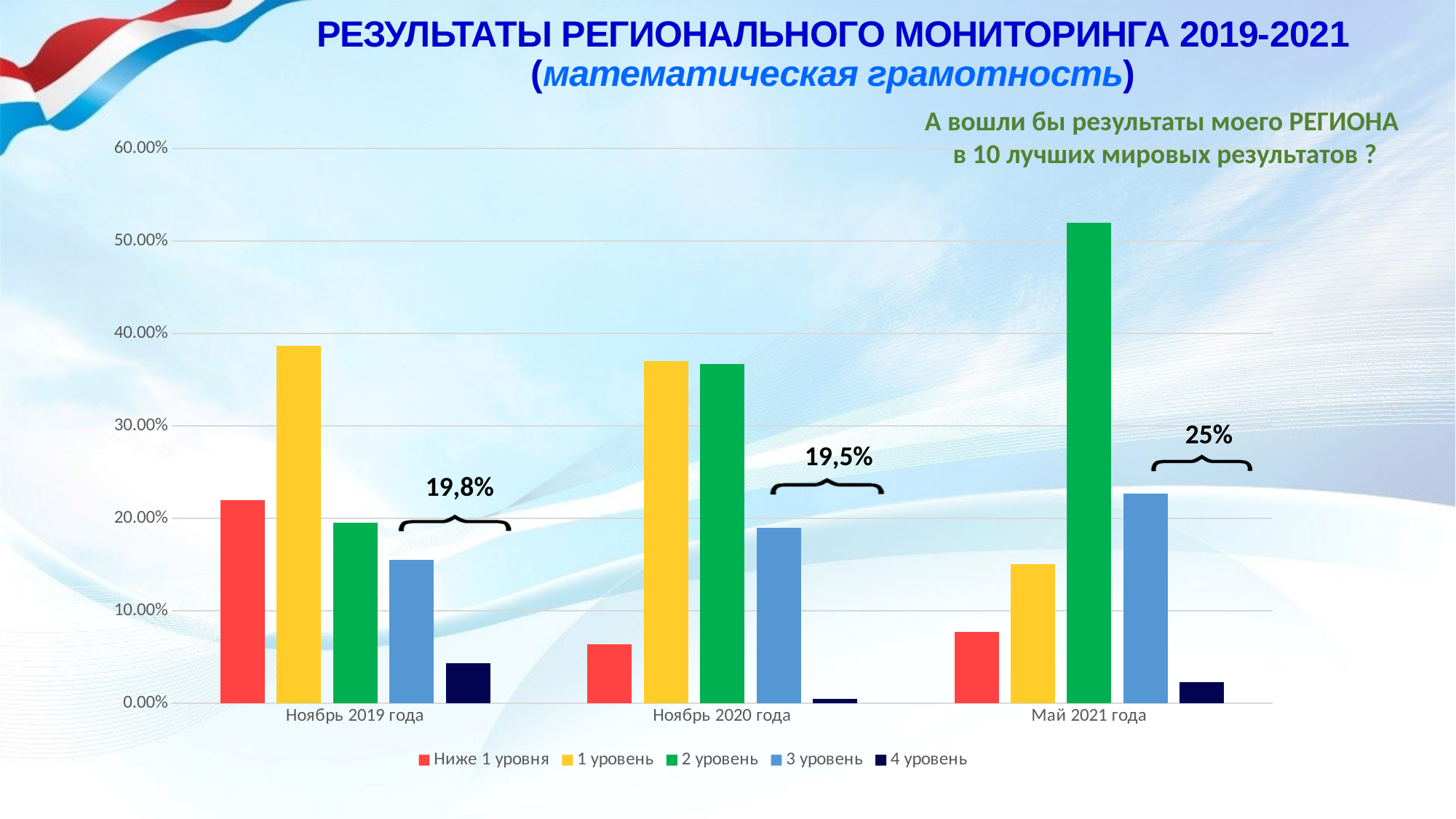
Which is larger: Ниже 1 уровня in Ноябрь 2019 года or Ниже 1 уровня in Май 2021 года? Ноябрь 2019 года Is the value for 2 уровень in Май 2021 года greater or less than 50.00%? greater What percentage is written above the brace for Май 2021 года? 25% Does the value for 2 уровень rise or fall from Ноябрь 2019 года to Май 2021 года? rise Which series has the highest value in Май 2021 года? 2 уровень Which series has the highest value in Ноябрь 2019 года? 1 уровень How many categories (time periods) are shown on the x axis? 3 Which is larger: 4 уровень in Ноябрь 2019 года or 4 уровень in Май 2021 года? Ноябрь 2019 года How many series does the legend list? 5 Is the value for Ниже 1 уровня in Ноябрь 2019 года greater or less than 20.00%? greater What kind of chart is shown on the slide? bar chart Which series has the lowest value in Ноябрь 2020 года? 4 уровень